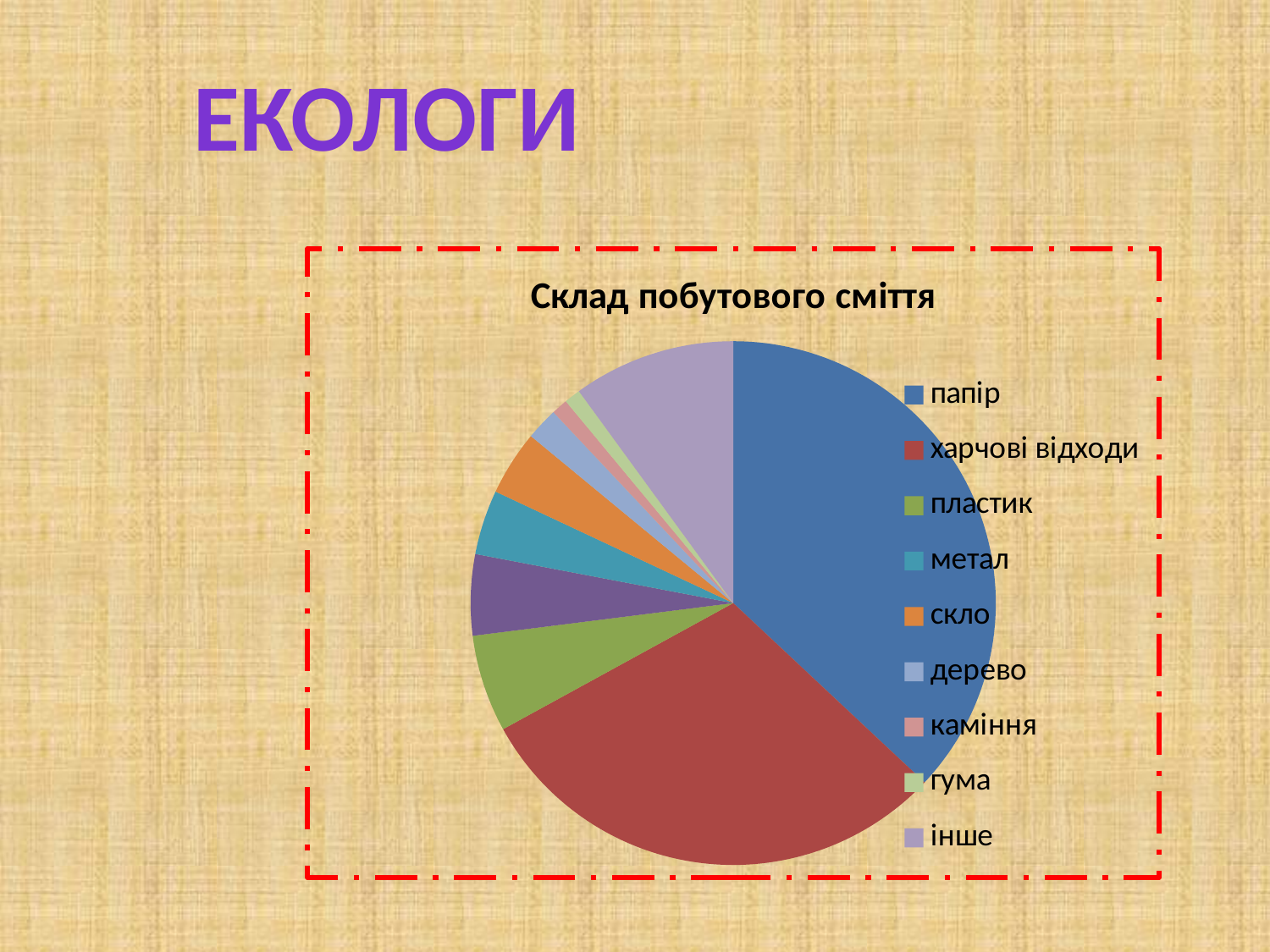
Which category has the largest slice of the pie? папір What colour is the slice for папір? blue How many categories (slices) does the pie chart have? 10 Which is larger, the slice for папір or the slice for харчові відходи? папір Which is larger, the slice for скло or the slice for дерево? скло Which is larger, the slice for харчові відходи or the slice for пластик? харчові відходи How many entries does the legend list? 9 What kind of chart is shown on the slide? pie chart What is the title of the chart? Склад побутового сміття